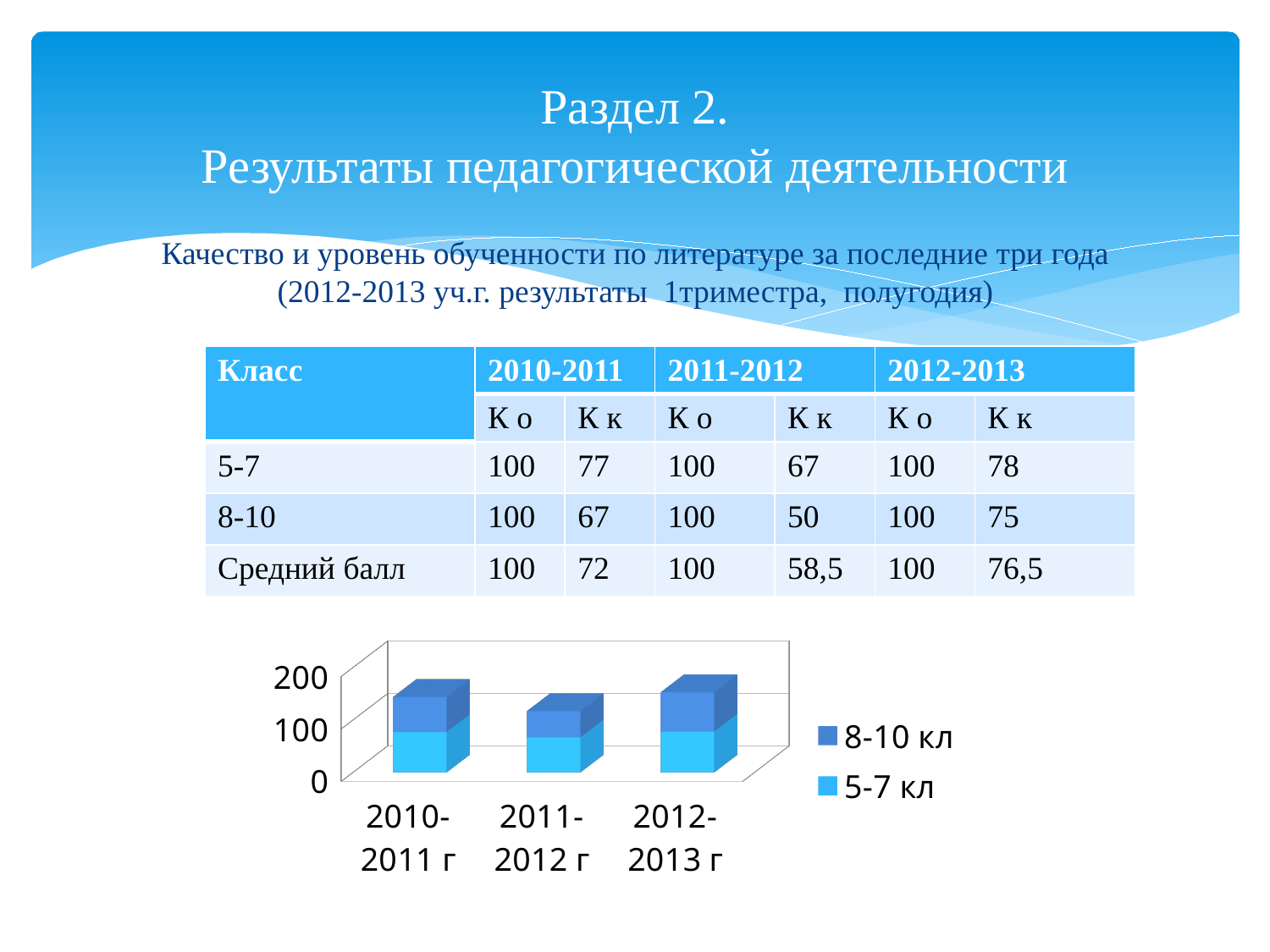
How many series does the chart legend list? 2 Which school year has the tallest stacked bar in the chart? 2012-2013 г What are the two series named in the chart legend? 8-10 кл and 5-7 кл Which school year has the shortest stacked bar in the chart? 2011-2012 г What kind of chart is shown on the slide? bar chart Is the total height of the stacked bar for 2011-2012 г greater or less than 200? less Is the total height of the stacked bar for 2010-2011 г greater or less than 200? less Is the total height of the stacked bar for 2012-2013 г greater or less than 100? greater How many categories (school years) are shown on the x axis of the chart? 3 Which series is drawn at the bottom of each stacked bar in the chart? 5-7 кл Which stacked bar is taller in the chart, 2011-2012 г or 2012-2013 г? 2012-2013 г Does the total bar height fall or rise from 2010-2011 г to 2011-2012 г in the chart? fall